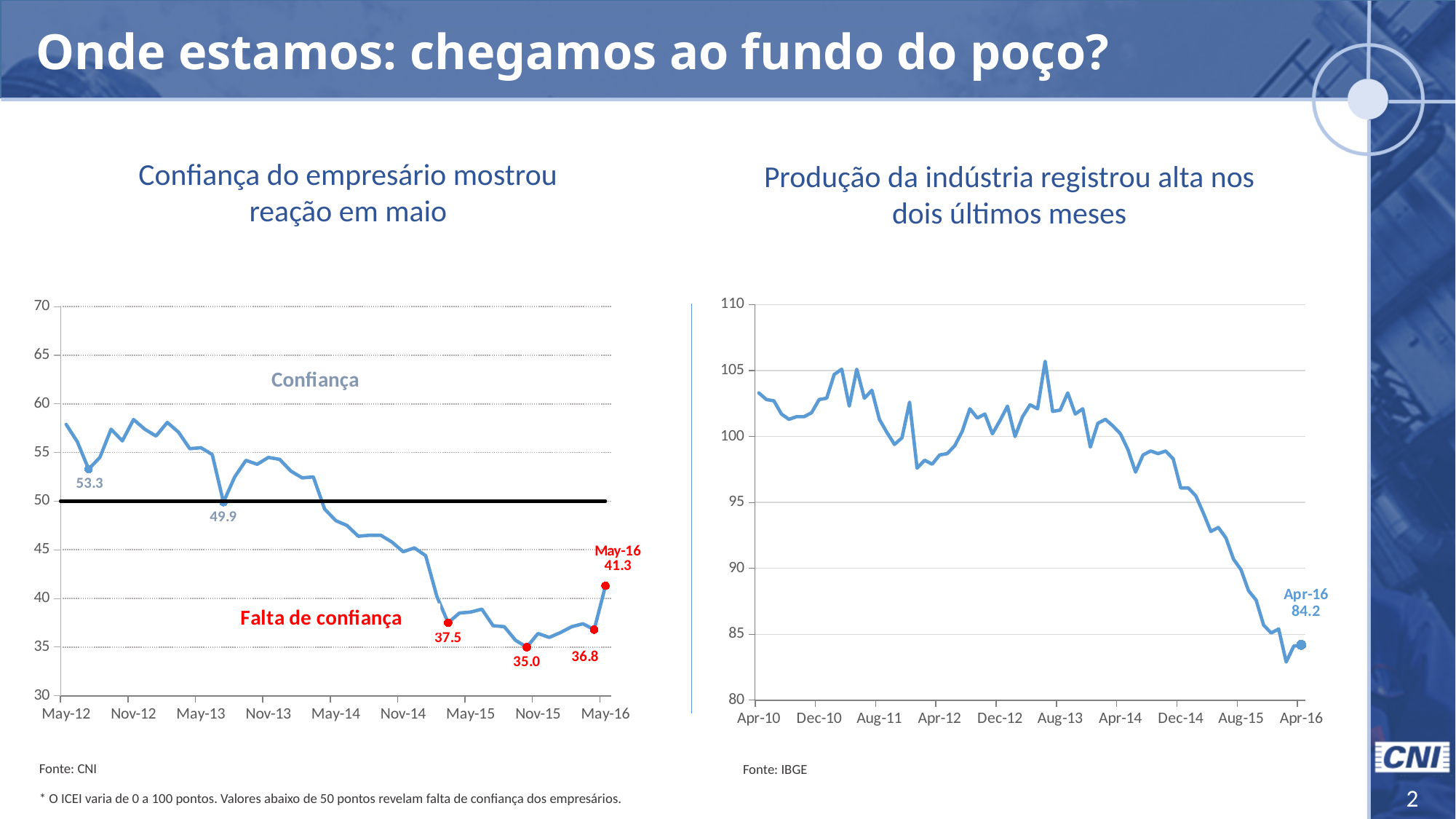
On the left chart (Confiança do empresário), what is the value for May-16? 41.3 On the left chart, what is the lowest labelled value on the line? 35.0 What kind of chart is the right chart (Produção da indústria)? Line chart On the right chart (Produção da indústria), what is the value for Apr-16? 84.2 On the right chart, do the values generally rise or fall from Aug-13 to Apr-16? Fall On the left chart, what is the difference between the May-16 value (41.3) and the labelled value 36.8 just before it? 4.5 On the left chart, which is larger: the labelled value 37.5 or the labelled value 36.8? 37.5 On the left chart, is the value for May-16 greater or less than 50? less On the right chart, is the value for Apr-16 greater or less than 85? less On the left chart, what is the difference between the labelled values 53.3 and 49.9? 3.4 On the left chart, at what value is the horizontal black reference line drawn? 50 What is the source cited below the right chart? Fonte: IBGE